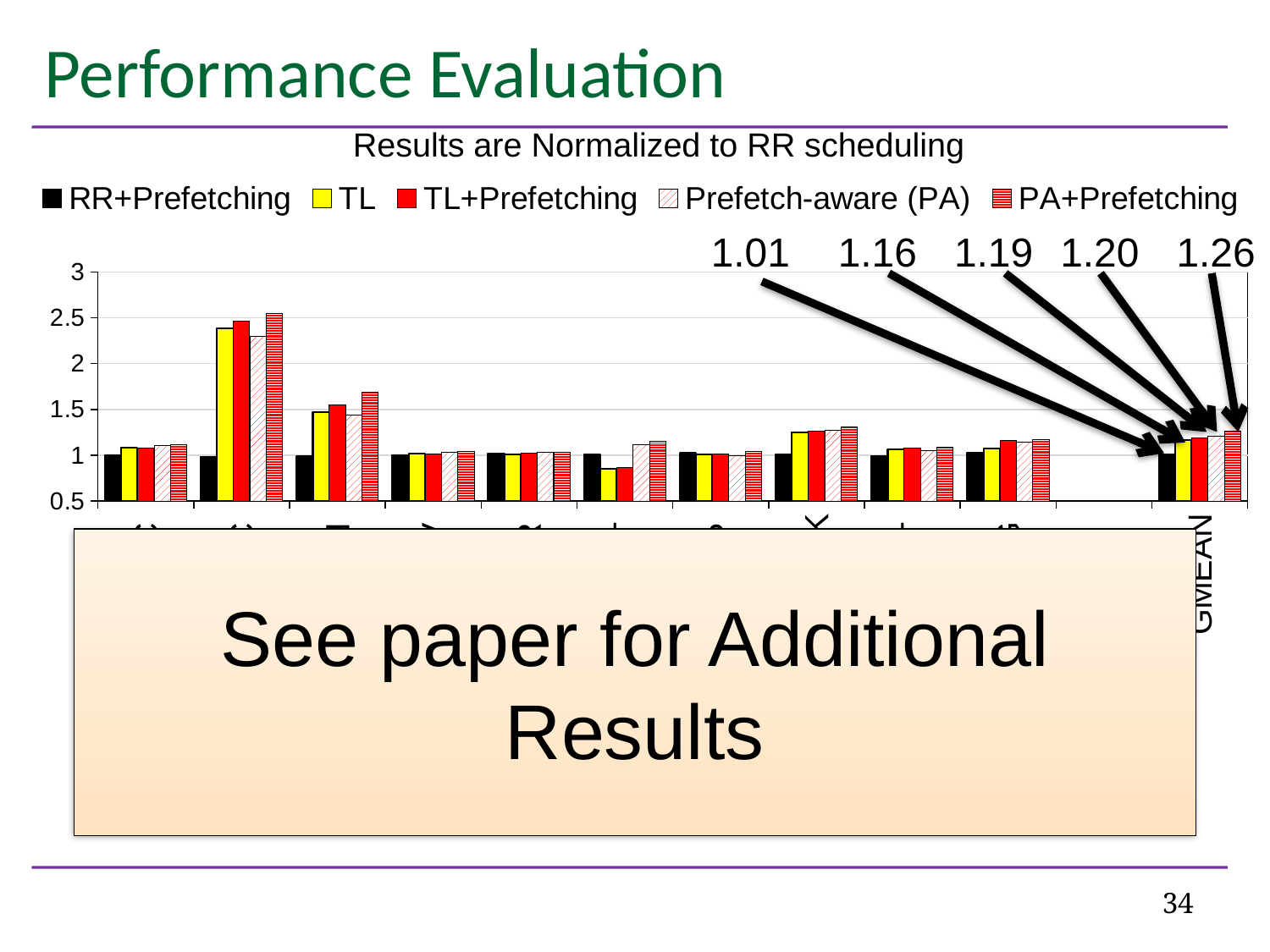
What is the difference between the GMEAN values of PA+Prefetching and RR+Prefetching? 0.25 What is the GMEAN value for RR+Prefetching? 1.01 Which series has the lowest GMEAN value? RR+Prefetching What is the GMEAN value for TL+Prefetching? 1.19 Which series has the highest GMEAN value? PA+Prefetching At GMEAN, which is larger: TL or TL+Prefetching? TL+Prefetching What is the GMEAN value for Prefetch-aware (PA)? 1.20 What is the title of the chart? Results are Normalized to RR scheduling What kind of chart is shown on the slide? bar chart What is the GMEAN value for TL? 1.16 How many series does the legend list? 5 What is the GMEAN value for PA+Prefetching? 1.26